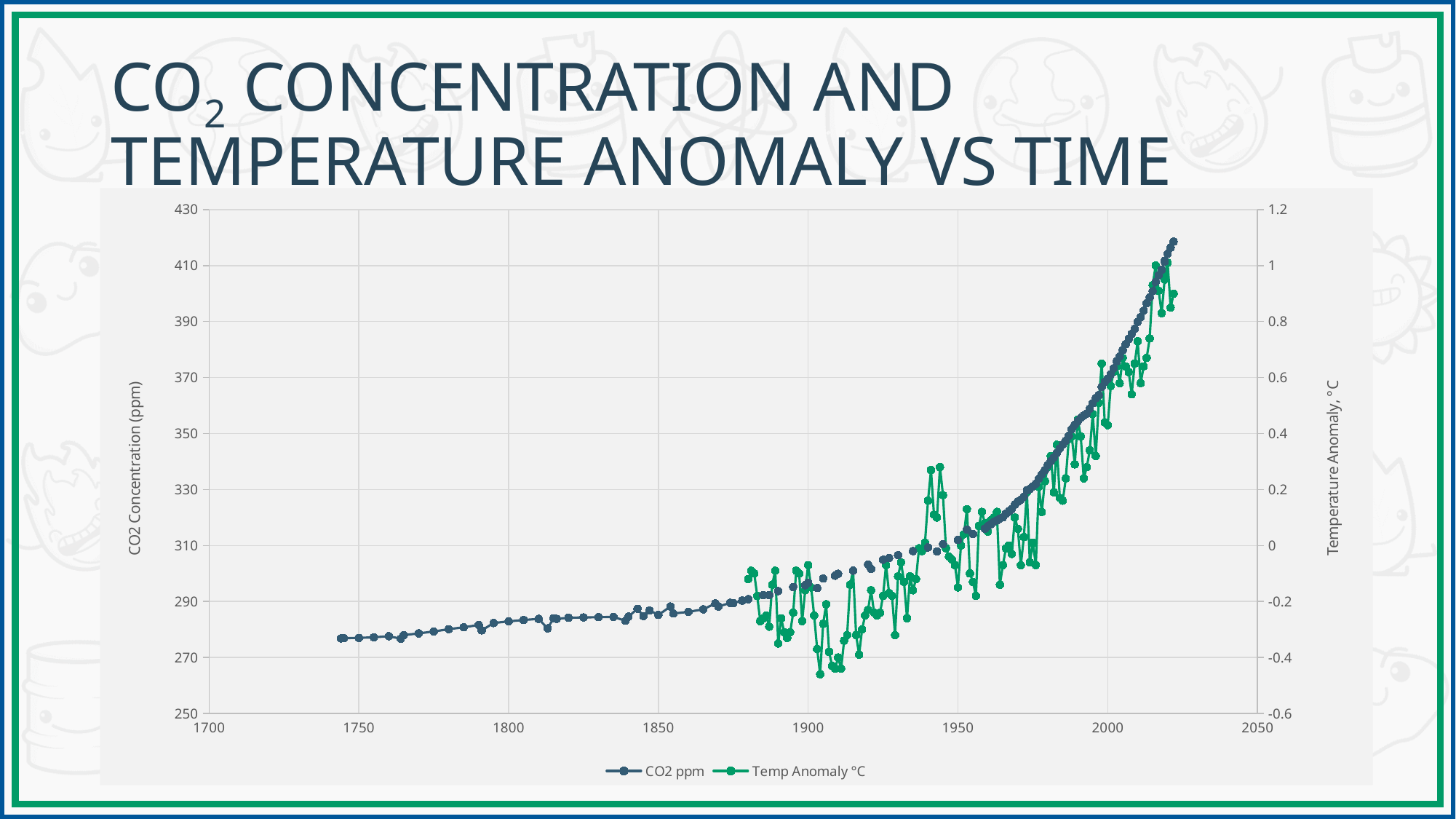
Is the CO2 ppm value around the year 1900 greater or less than 310? less Is the CO2 ppm value around the year 2000 greater or less than 350? greater What are the two series named in the legend? CO2 ppm and Temp Anomaly °C Is the Temp Anomaly °C value around the year 2020 greater or less than 0.6? greater What is the title of the left vertical axis? CO2 Concentration (ppm) Does the CO2 ppm series rise or fall as the years increase along the x axis? Rise How many series does the legend list? 2 What kind of chart is shown on the slide? Line chart Which is larger, the Temp Anomaly °C value around 2010 or around 1910? Around 2010 Which is larger, the CO2 ppm value around 2000 or the CO2 ppm value around 1900? Around 2000